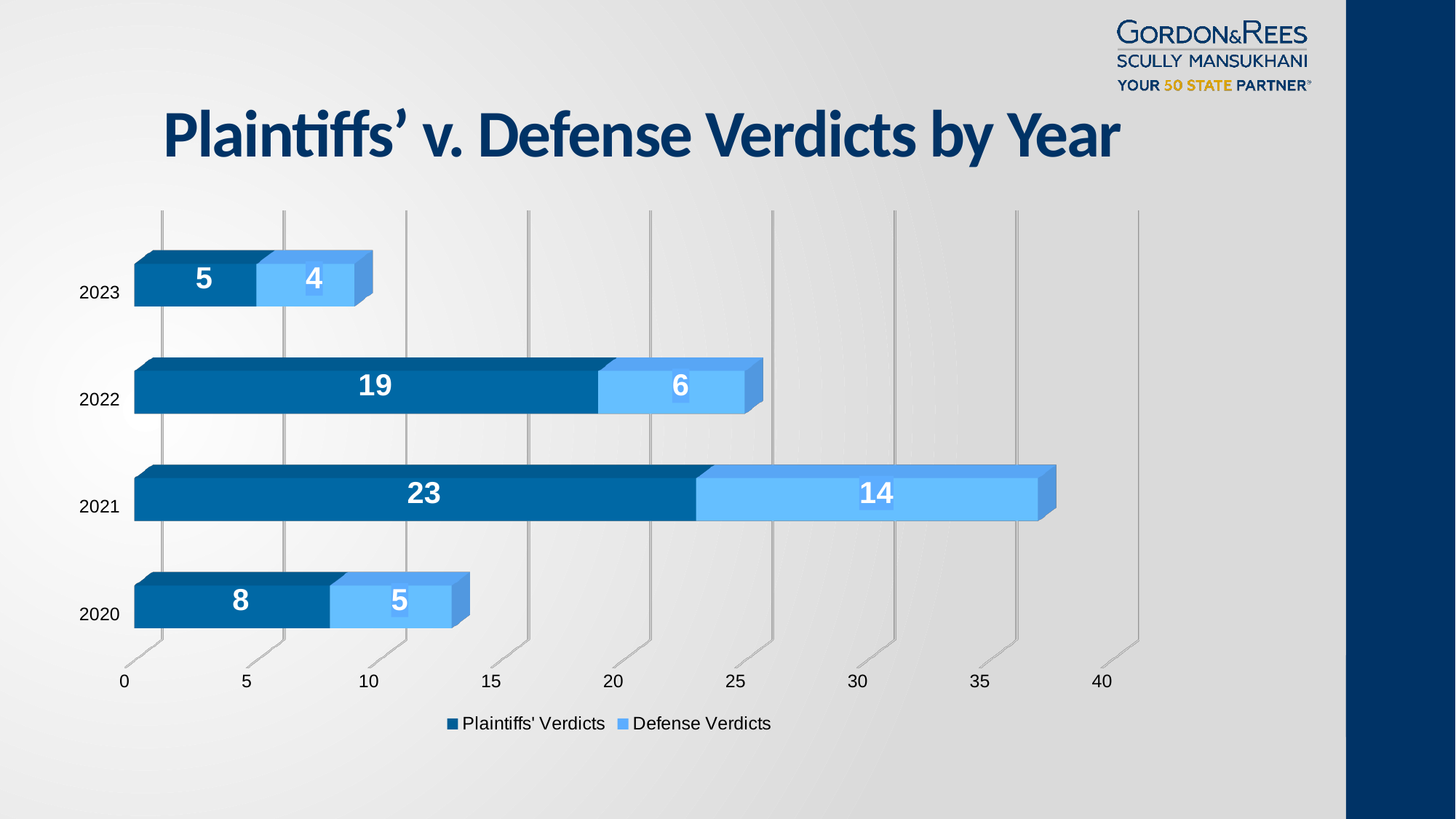
What is the total number of verdicts in 2021? 37 What type of chart is shown on the slide? Stacked bar chart How many series does the legend list? 2 How many Plaintiffs' Verdicts were there in 2021? 23 What is the difference between Plaintiffs' Verdicts and Defense Verdicts in 2022? 13 How many Defense Verdicts were there in 2022? 6 Which year had the highest number of Plaintiffs' Verdicts? 2021 How many Defense Verdicts were there in 2023? 4 What is the total number of verdicts in 2020? 13 Which year had the lowest number of Defense Verdicts? 2023 Which is larger: Plaintiffs' Verdicts in 2020 or Defense Verdicts in 2021? Defense Verdicts in 2021 How many years are shown on the chart? 4